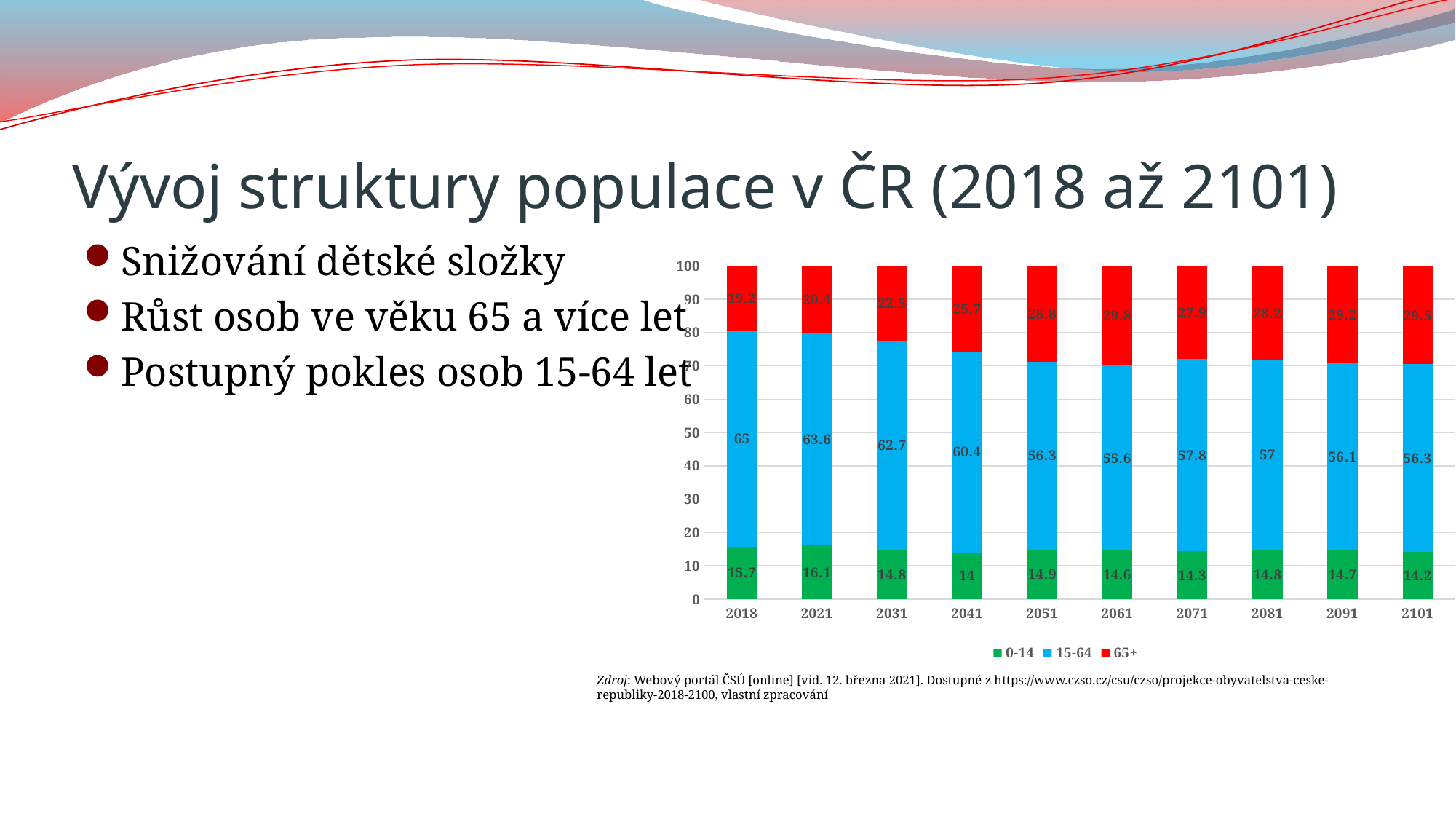
What kind of chart is shown on the slide? Stacked bar chart What is the difference between the 15-64 value for 2018 and the 15-64 value for 2101? 8.7 What is the total of the stacked bar for 2061? 100 How many series does the chart legend list? 3 What is the value of the 65+ series for 2101? 29.5 In which year is the 0-14 series highest? 2021 In which year is the 15-64 series lowest? 2061 Does the 65+ series rise or fall from 2018 to 2061? Rises How many years are shown on the x axis of the chart? 10 What is the value of the 0-14 series for 2041? 14 What is the value of the 15-64 series for 2018? 65 In which year is the 65+ series highest? 2061